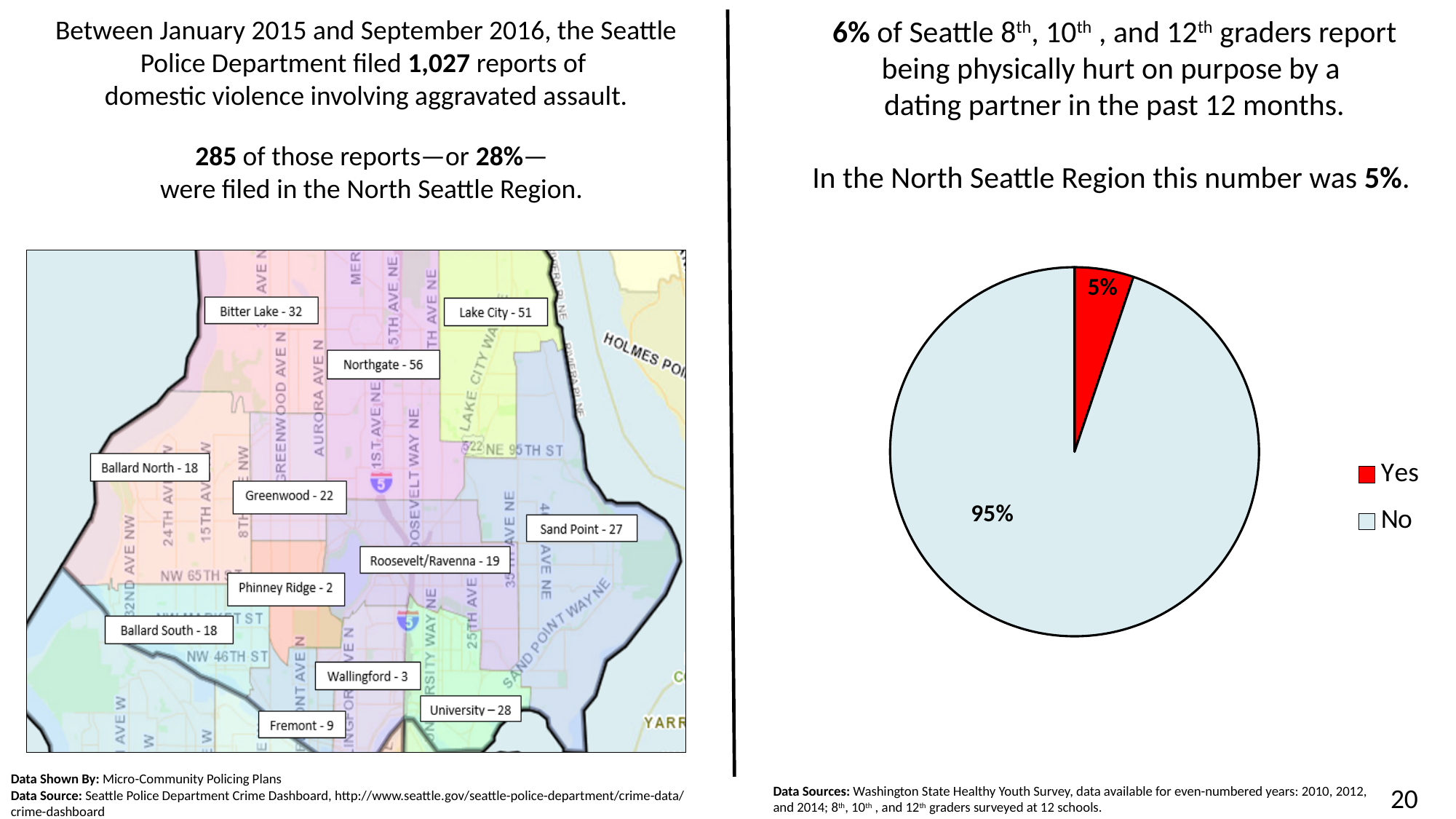
In the pie chart on the right, what percentage is shown for the 'No' slice? 95% In the pie chart on the right, which category has the largest slice? No In the pie chart on the right, how many slices does the pie have? 2 In the pie chart on the right, what is the difference in percentage points between the 'No' and 'Yes' slices? 90% On the map on the left, which labeled neighborhood has the lowest number of reports? Phinney Ridge In the pie chart on the right, what colour is the 'Yes' slice? red In the pie chart on the right, how many entries does the legend list? 2 What kind of chart is shown on the right side of the slide? pie chart In the pie chart on the right, what percentage is shown for the 'Yes' slice? 5% In the pie chart on the right, which category has the smallest slice? Yes On the map on the left, how many reports are labeled for Northgate? 56 On the map on the left, which labeled neighborhood has the highest number of reports? Northgate